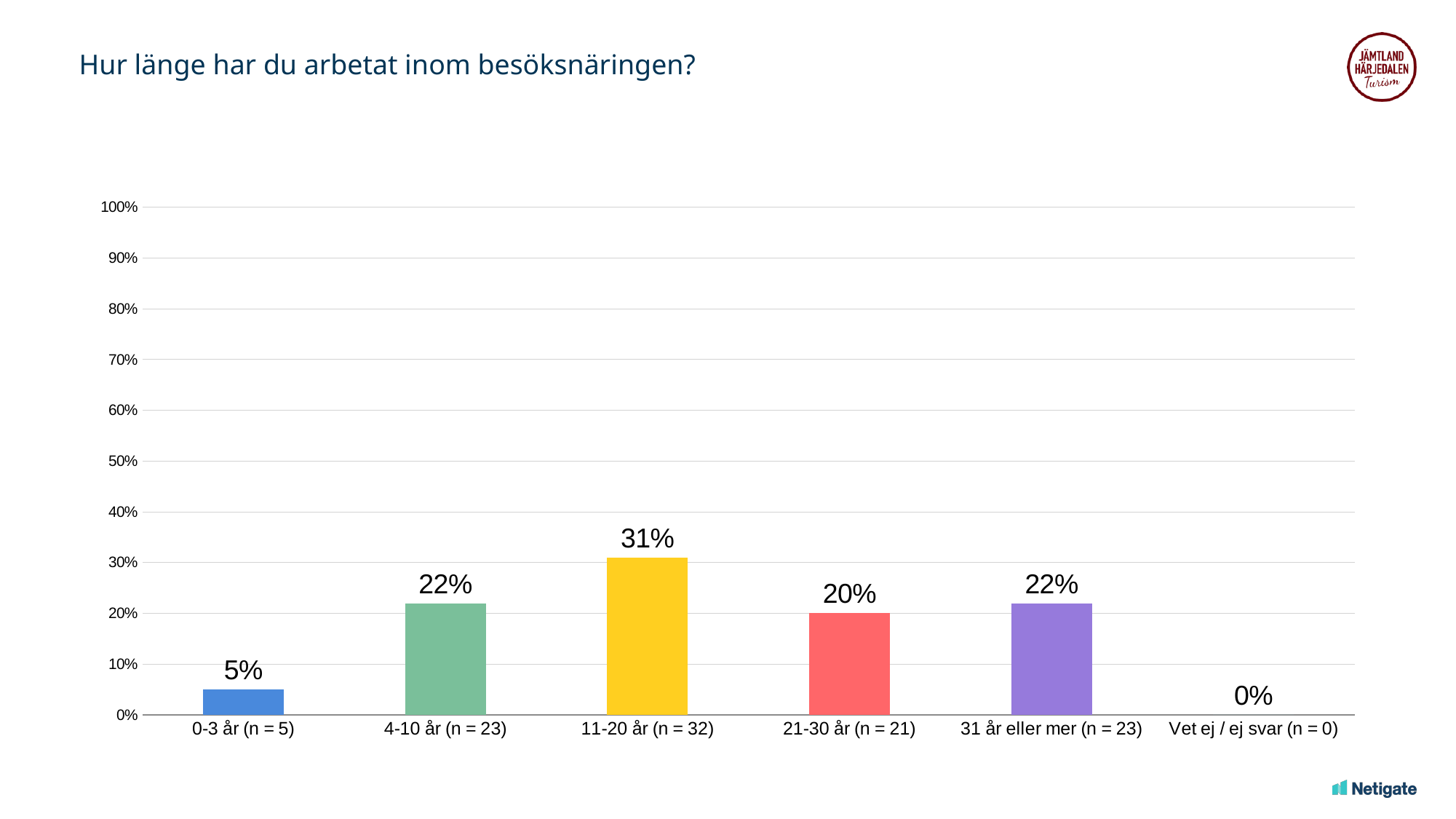
How many categories are shown on the x axis? 6 What kind of chart is shown on the slide? bar chart What is the title of the slide? Hur länge har du arbetat inom besöksnäringen? Which category has the highest value? 11-20 år (n = 32) Which is larger, the value for 4-10 år (n = 23) or the value for 21-30 år (n = 21)? 4-10 år (n = 23) Is the value for 11-20 år (n = 32) greater or less than 30%? greater What is the value for Vet ej / ej svar (n = 0)? 0% Which category has the lowest value? Vet ej / ej svar (n = 0) What is the difference between the values for 11-20 år (n = 32) and 0-3 år (n = 5)? 26% What is the value for 21-30 år (n = 21)? 20% What is the value for 11-20 år (n = 32)? 31% What is the value for 0-3 år (n = 5)? 5%